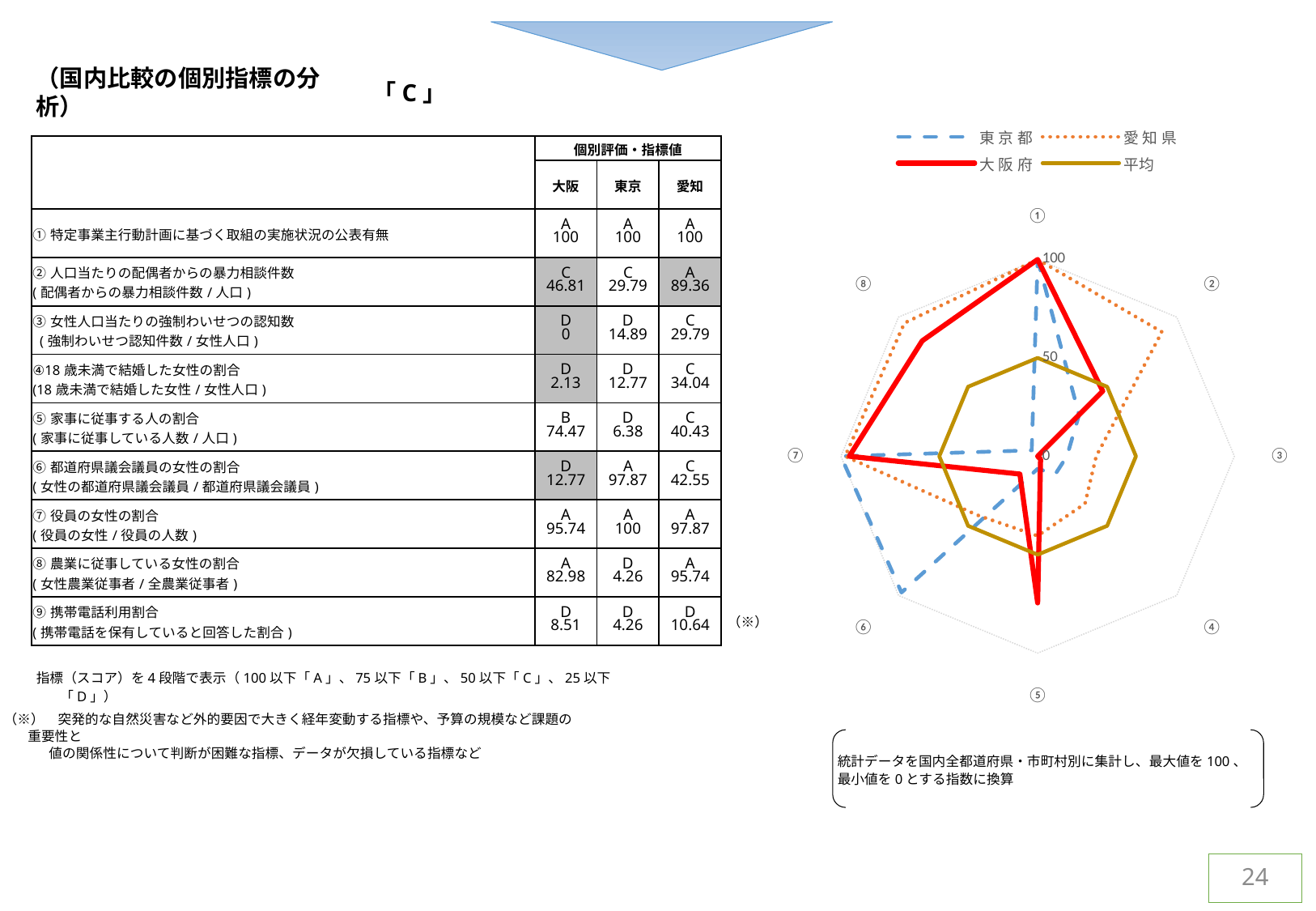
Which series has the lowest value on axis ③ of the radar chart? 大阪府 On axis ② of the radar chart, which is larger, 愛知県 or 東京都? 愛知県 What kind of chart is shown on the right of the slide? radar chart Which series has the highest value on axis ⑤ of the radar chart? 大阪府 How many series does the legend of the radar chart list? 4 Which series in the radar chart is drawn with a solid red line? 大阪府 How many axes (categories) does the radar chart have? 8 Is the value for 東京都 on axis ⑧ of the radar chart greater or less than 50? less What is the difference between 愛知県 and 東京都 on axis ② of the radar chart? 59.57 What is the maximum value shown on the radar chart's axis scale? 100 What is the value for 大阪府 on axis ② of the radar chart? 46.81 What is the value for 東京都 on axis ⑥ of the radar chart? 97.87